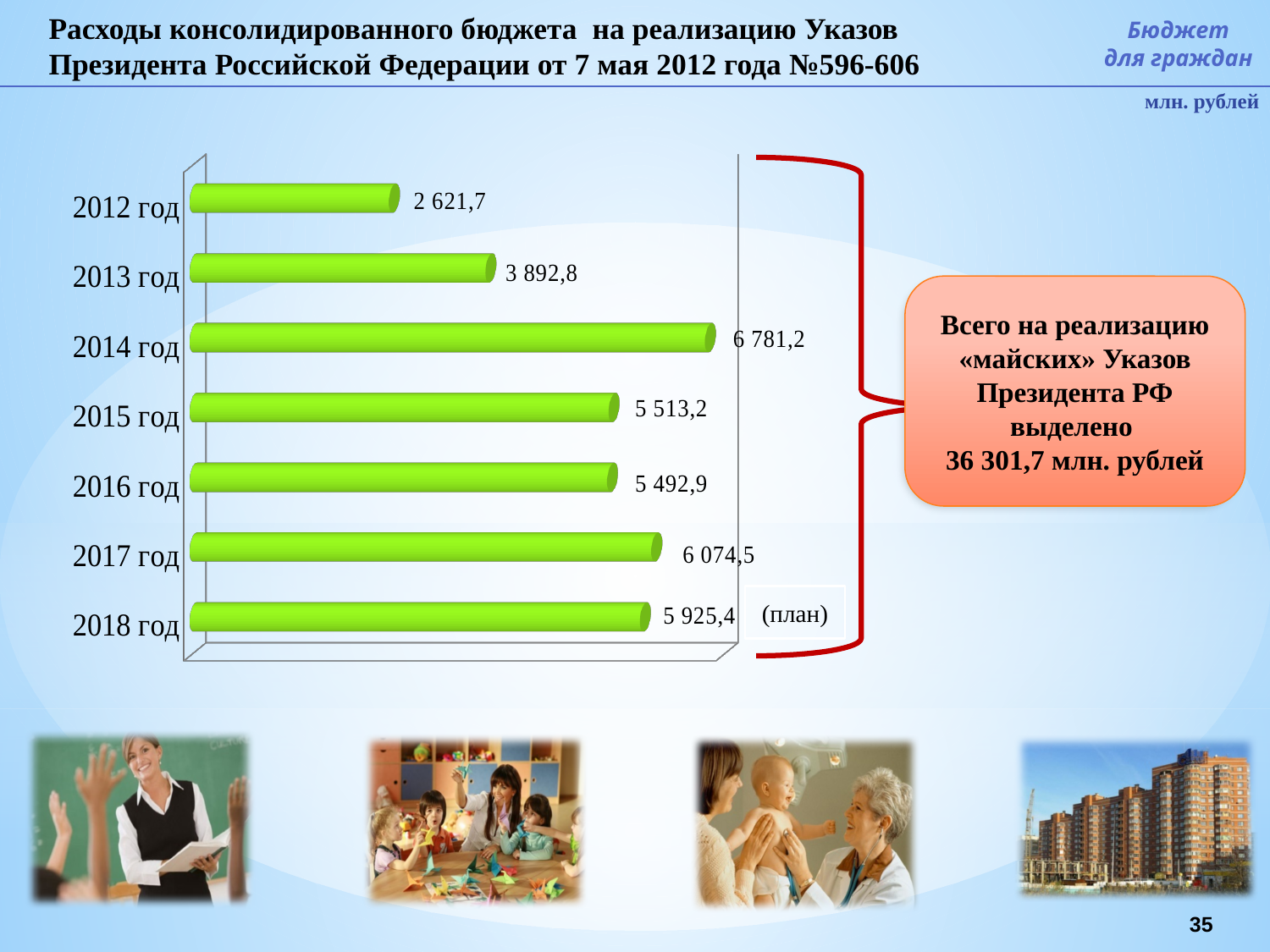
Do the values rise or fall from 2012 год to 2014 год? rise What is the difference between the values for 2014 год and 2012 год? 4 159,5 Which year has the lowest value? 2012 год Which is larger, the value for 2013 год or the value for 2015 год? 2015 год What is the planned value for 2018 год? 5 925,4 What is the difference between the values for 2017 год and 2018 год? 149,1 What is the value for 2016 год? 5 492,9 What is the value for 2012 год? 2 621,7 Which year has the highest value? 2014 год What kind of chart is shown on the slide? bar chart In what units are the chart values given? млн. рублей How many years are shown in the chart? 7